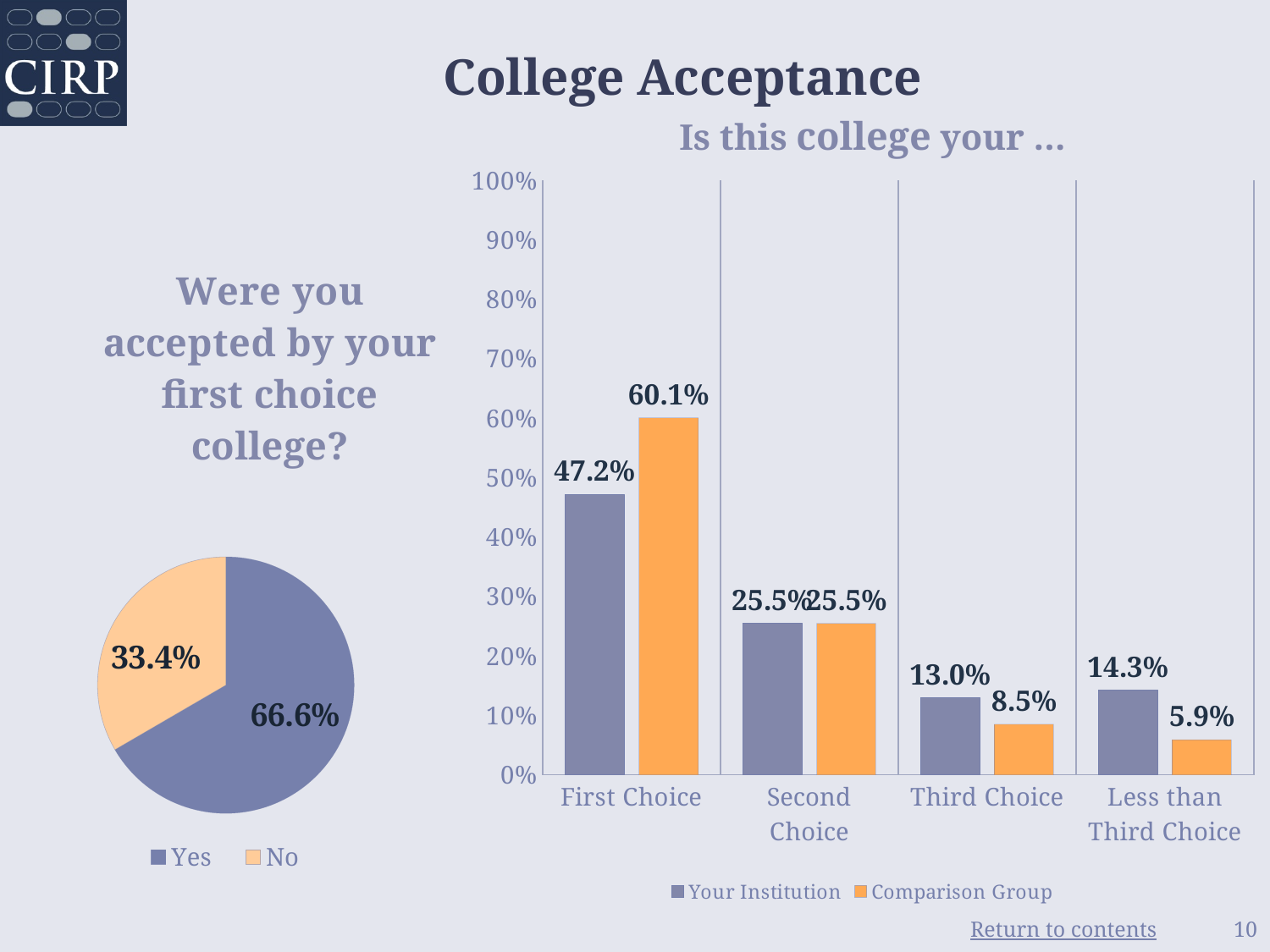
In the bar chart 'Is this college your ...', what is the value for Comparison Group for Less than Third Choice? 5.9% In the bar chart 'Is this college your ...', which category has the lowest Your Institution value? Third Choice In the bar chart 'Is this college your ...', which is larger for Third Choice: Your Institution or Comparison Group? Your Institution In the bar chart 'Is this college your ...', do the Comparison Group values rise or fall from First Choice to Less than Third Choice? fall In the bar chart 'Is this college your ...', which category has the highest Comparison Group value? First Choice What type of chart is the chart on the left of the slide? pie chart In the bar chart 'Is this college your ...', what is the difference between the Comparison Group and Your Institution values for First Choice? 12.9% In the bar chart 'Is this college your ...', how many series does the legend list? 2 In the bar chart 'Is this college your ...', how many categories are shown on the x axis? 4 In the pie chart 'Were you accepted by your first choice college?', what share of the pie is Yes? 66.6% In the pie chart 'Were you accepted by your first choice college?', which slice is larger: Yes or No? Yes In the bar chart 'Is this college your ...', what is the value for Your Institution for First Choice? 47.2%